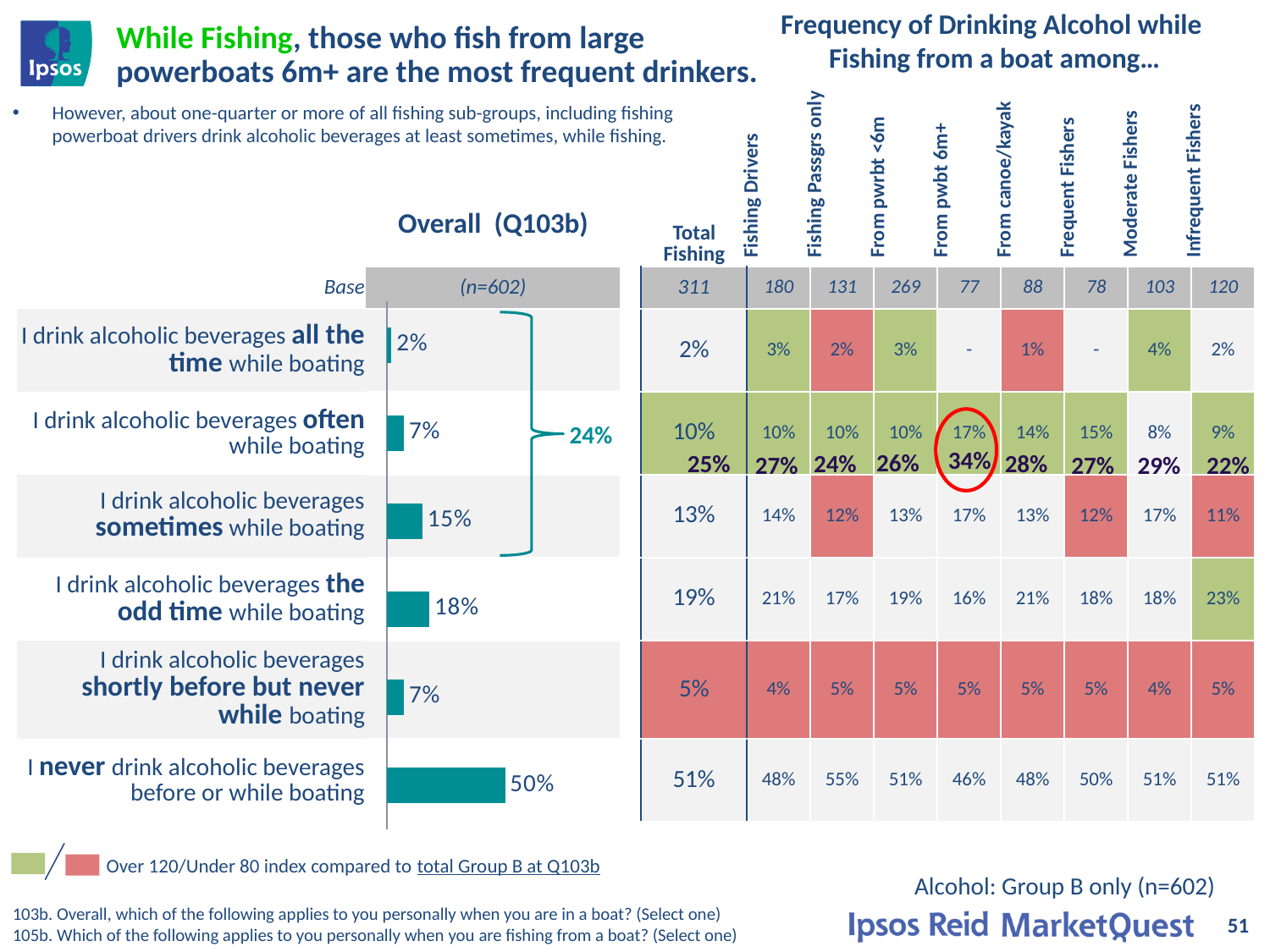
In the Overall (Q103b) chart, what percentage drink alcoholic beverages shortly before but never while boating? 7% In the Overall (Q103b) chart, what is the value for 'I drink alcoholic beverages the odd time while boating'? 18% In the Overall (Q103b) chart, what percentage of respondents say they never drink alcoholic beverages before or while boating? 50% In the Overall (Q103b) chart, which is larger: the value for 'sometimes' or the value for 'the odd time'? the odd time In the Overall (Q103b) chart, what is the difference between the 'never' value and the 'the odd time' value? 32% What is the base sample size shown for the Overall (Q103b) chart? n=602 In the Overall (Q103b) chart, which category has the highest value? I never drink alcoholic beverages before or while boating What type of chart is the Overall (Q103b) chart? bar chart In the Overall (Q103b) chart, what combined percentage is shown by the bracket grouping 'all the time', 'often' and 'sometimes'? 24% In the Overall (Q103b) chart, what is the value for 'I drink alcoholic beverages sometimes while boating'? 15% How many categories are shown in the Overall (Q103b) bar chart? 6 In the Overall (Q103b) chart, which category has the lowest value? I drink alcoholic beverages all the time while boating